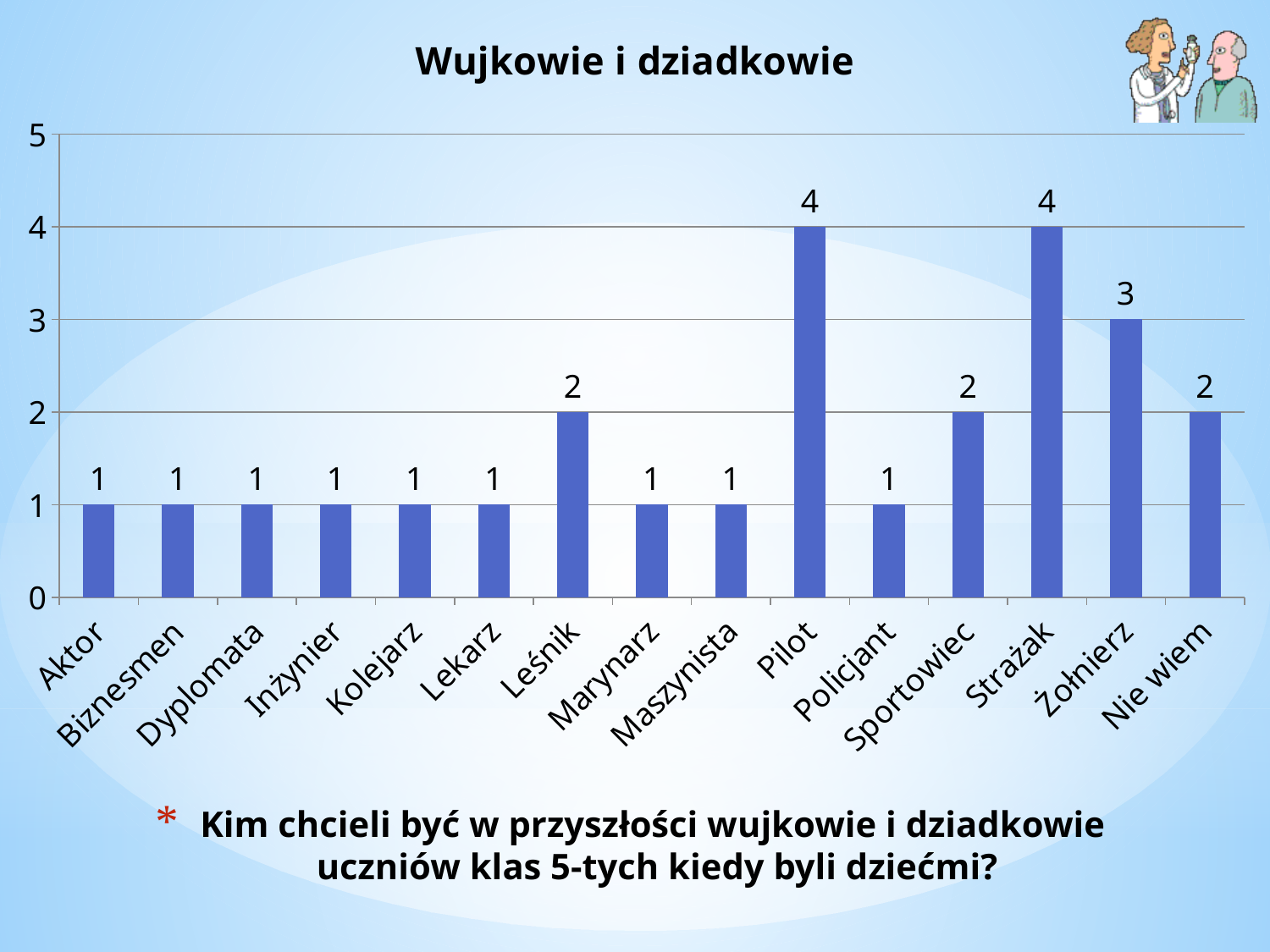
What is the difference between the values for Pilot and Sportowiec? 2 What is the value for Żołnierz? 3 How many categories are shown on the x axis? 15 Which two categories share the highest value? Pilot and Strażak What is the title of the chart? Wujkowie i dziadkowie What kind of chart is shown on the slide? Bar chart What is the value for Leśnik? 2 Which is larger, the value for Żołnierz or the value for Sportowiec? Żołnierz What is the value for Policjant? 1 What is the value for Pilot? 4 What is the value for Nie wiem? 2 What is the difference between the values for Strażak and Żołnierz? 1